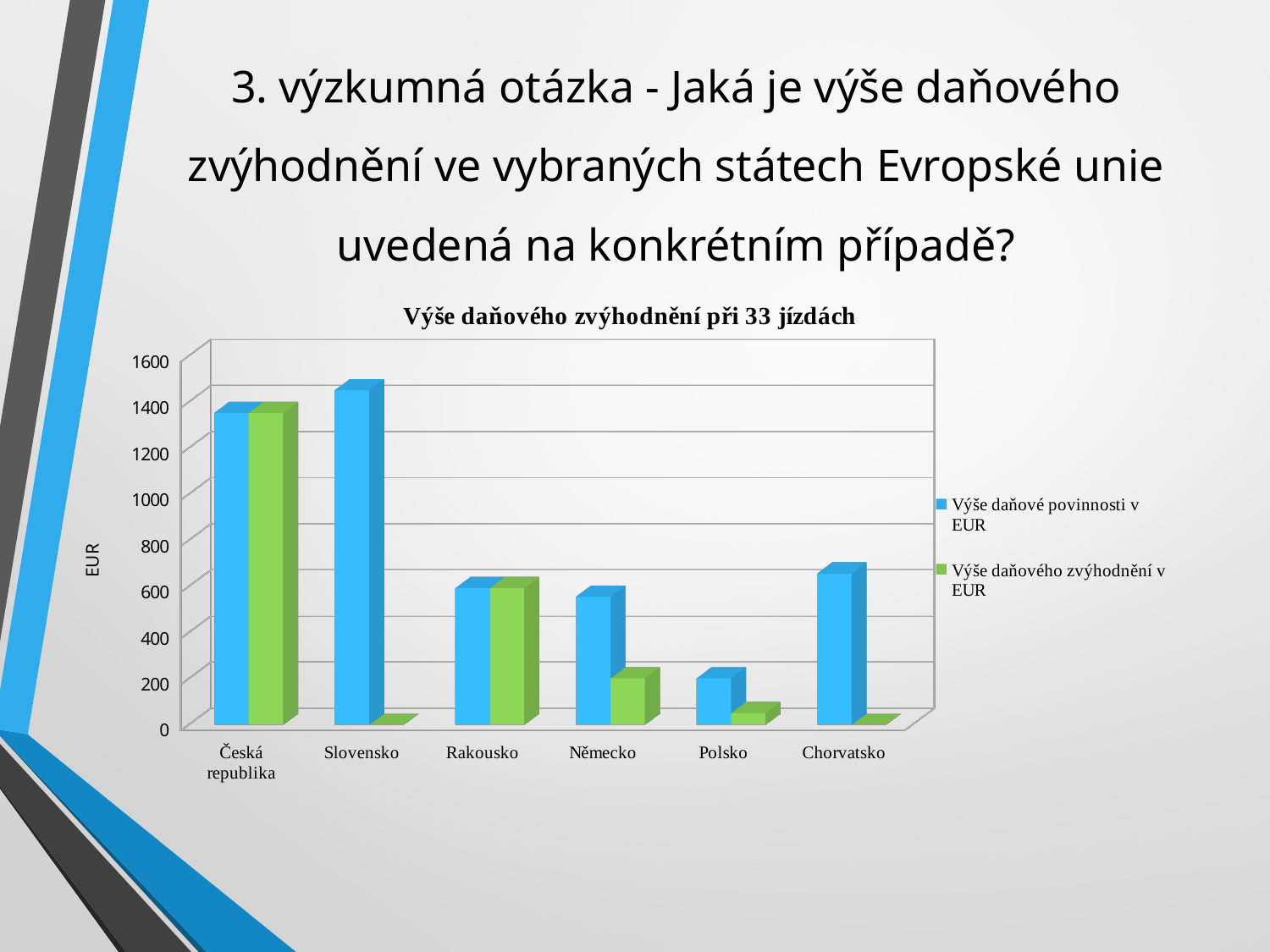
Is the value of 'Výše daňové povinnosti v EUR' for Polsko greater or less than 400? less What is the label of the vertical axis of the chart? EUR Is the value of 'Výše daňové povinnosti v EUR' for Slovensko greater or less than 1400? greater Which is larger: 'Výše daňové povinnosti v EUR' for Rakousko or for Polsko? Rakousko What is the title of the chart? Výše daňového zvýhodnění při 33 jízdách How many series does the chart legend list? 2 Is the value of 'Výše daňové povinnosti v EUR' for Chorvatsko greater or less than 600? greater What kind of chart is shown on the slide? bar chart Which country has the lowest value for 'Výše daňové povinnosti v EUR'? Polsko How many countries are shown on the x axis of the chart? 6 Which country has the highest value for 'Výše daňové povinnosti v EUR'? Slovensko